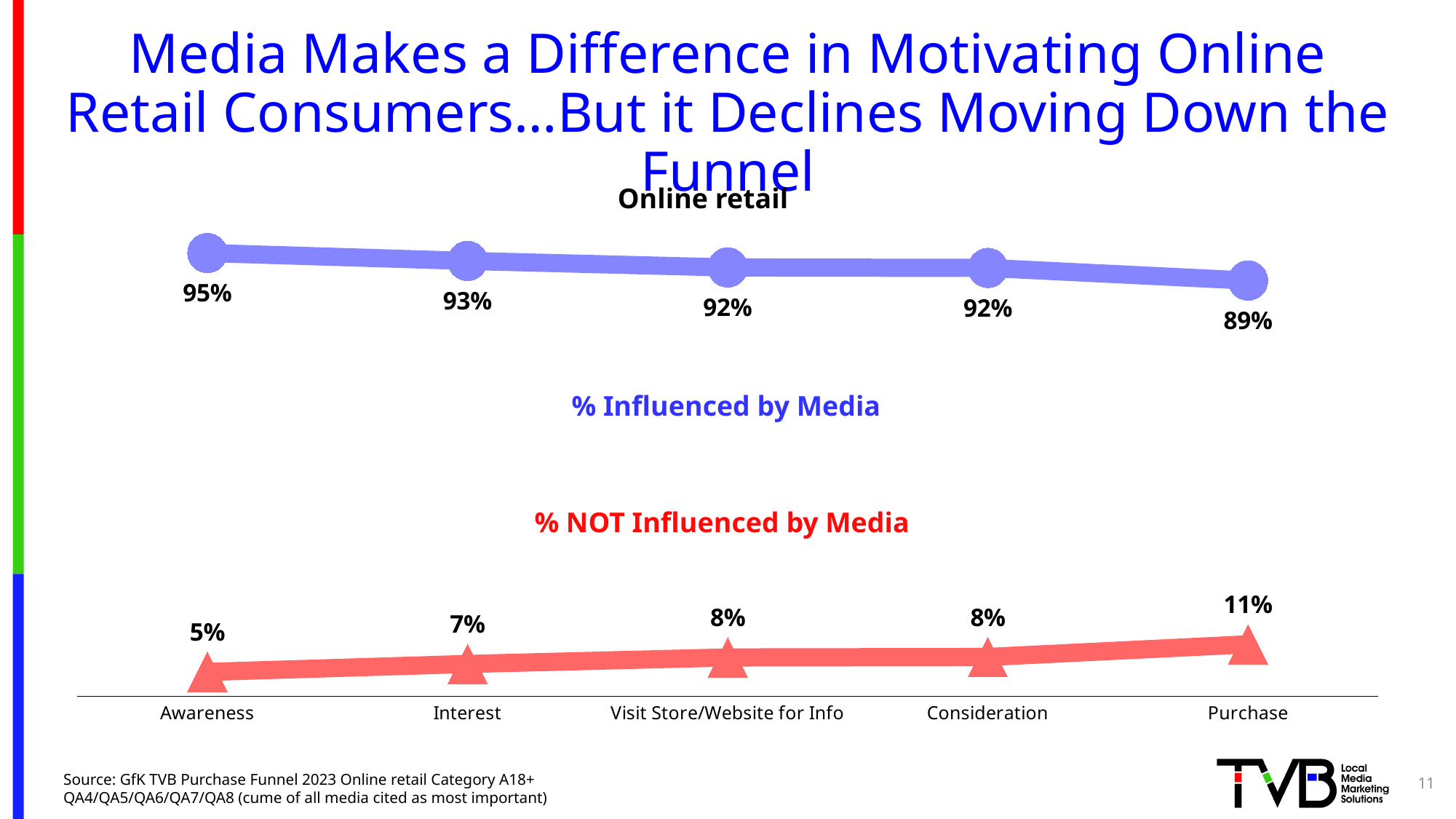
Does the % Influenced by Media series rise or fall moving from Awareness to Purchase? Fall What is the % NOT Influenced by Media value for Interest? 7% What is the difference between the % Influenced by Media values for Awareness and Purchase? 6% What is the % NOT Influenced by Media value for Purchase? 11% What is the % Influenced by Media value for Awareness? 95% How many data series are plotted on the chart? 2 Which is larger, the % NOT Influenced by Media value for Awareness or for Purchase? Purchase Which funnel stage has the lowest % Influenced by Media value? Purchase How many funnel stages are shown on the x axis? 5 What type of chart is shown on the slide? Line chart What is the % Influenced by Media value for Consideration? 92% Which funnel stage has the highest % NOT Influenced by Media value? Purchase